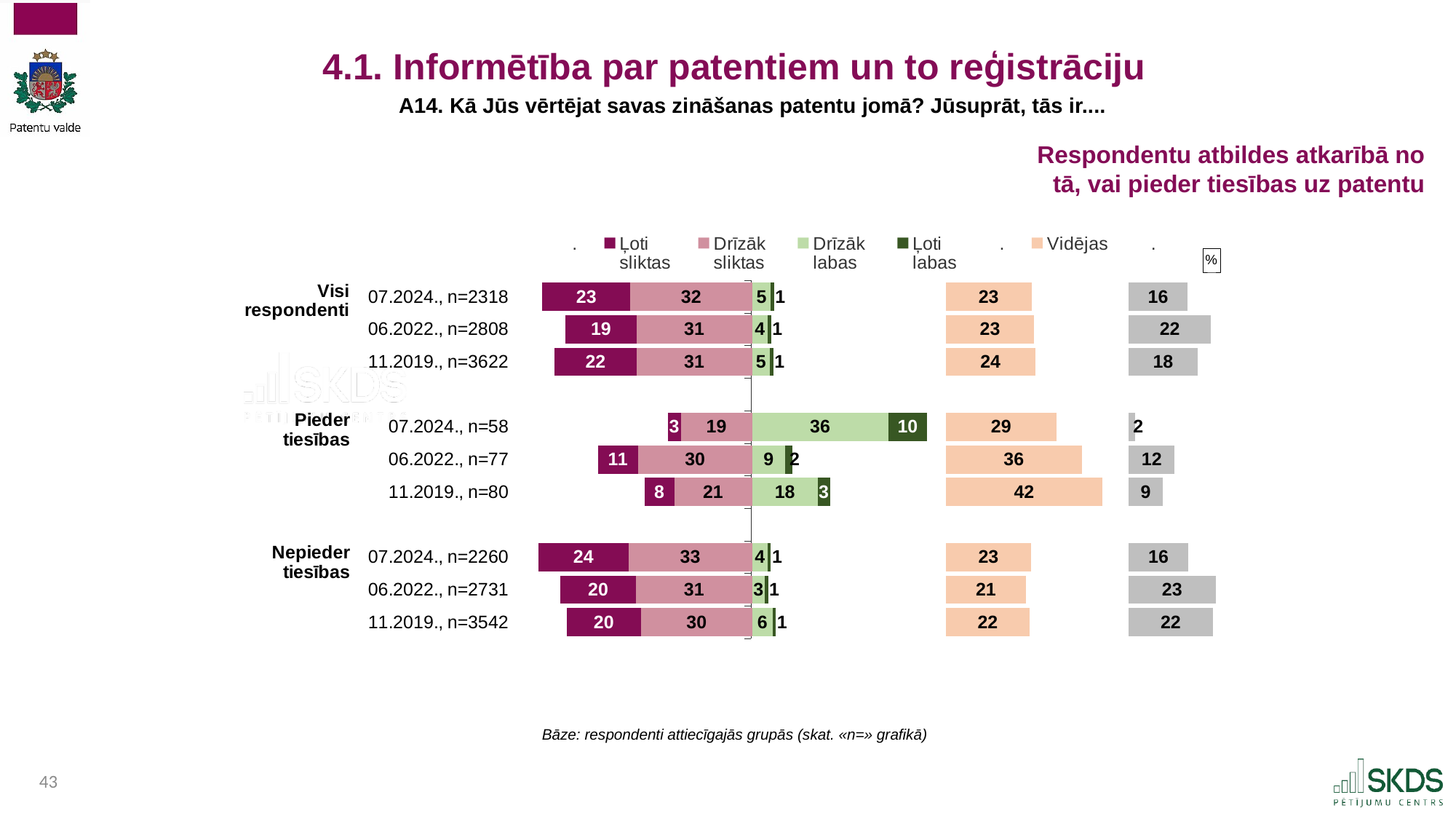
What is the value for "Vidējas" for Pieder tiesības, 11.2019., n=80? 42 Which row has the lowest value for "Ļoti sliktas"? Pieder tiesības, 07.2024., n=58 What is the combined value of "Ļoti sliktas" and "Drīzāk sliktas" for Visi respondenti, 06.2022., n=2808? 50 Which row has the highest value for "Ļoti labas"? Pieder tiesības, 07.2024., n=58 What is the sample size (n) shown for Pieder tiesības, 06.2022.? n=77 What is the value for "Drīzāk sliktas" for Nepieder tiesības, 07.2024., n=2260? 33 What kind of chart is shown on the slide? Stacked bar chart Which is larger: the "Ļoti sliktas" value for Nepieder tiesības 07.2024., n=2260 or for Visi respondenti 07.2024., n=2318? Nepieder tiesības 07.2024., n=2260 What is the value for "Ļoti sliktas" for Visi respondenti, 07.2024., n=2318? 23 What is the value for "Drīzāk labas" for Pieder tiesības, 07.2024., n=58? 36 What is the difference between the "Vidējas" values for Pieder tiesības 11.2019., n=80 and Pieder tiesības 07.2024., n=58? 13 How many respondent rows are plotted in the chart? 9